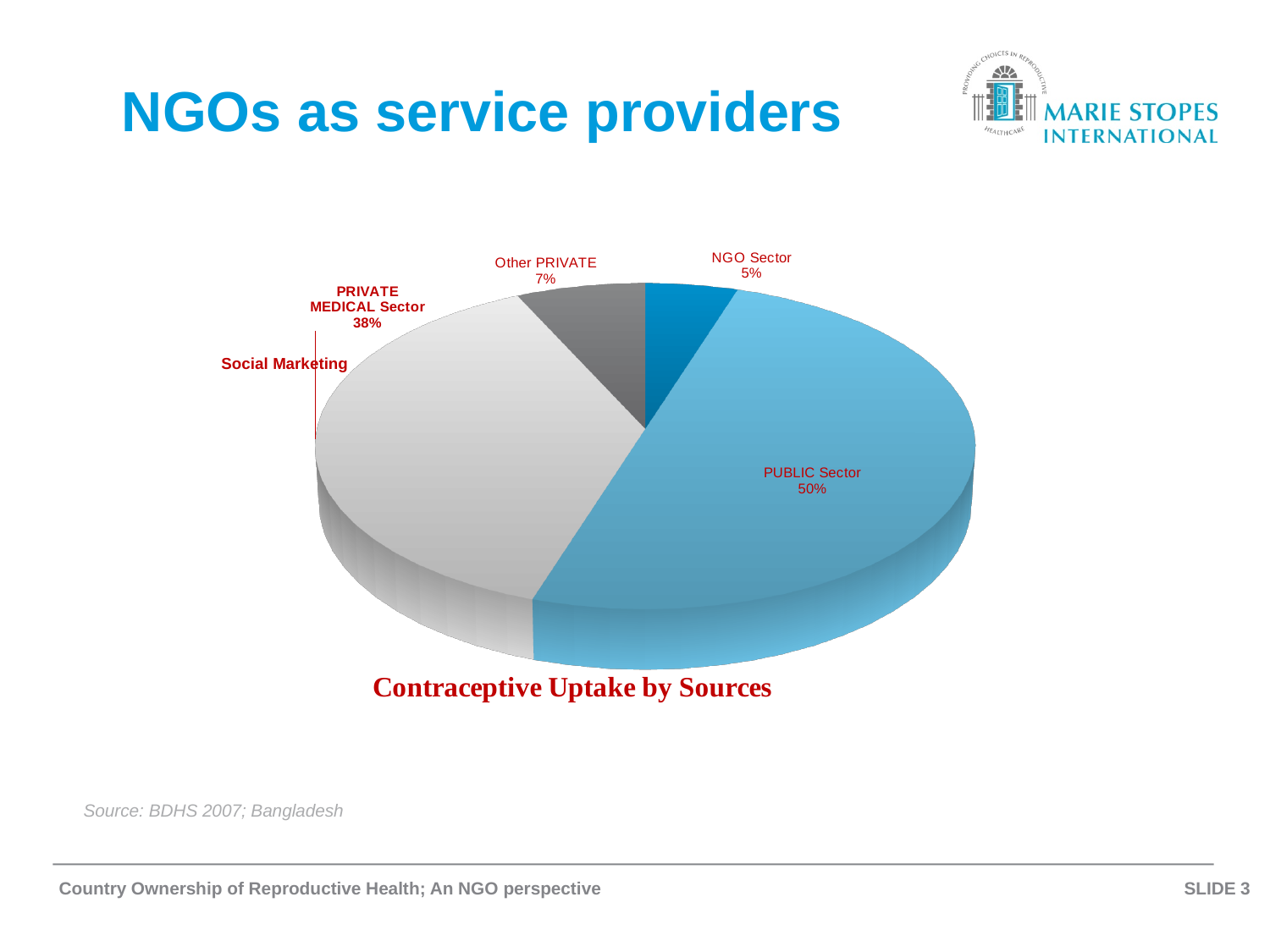
Which source has the smallest share of contraceptive uptake? NGO Sector What share of contraceptive uptake comes from the PRIVATE MEDICAL Sector? 38% What is the difference in percentage points between the PUBLIC Sector and the PRIVATE MEDICAL Sector shares? 12 What share of contraceptive uptake comes from Other PRIVATE sources? 7% How many slices does the pie chart have? 4 What is the title of the chart? Contraceptive Uptake by Sources What share of contraceptive uptake comes from the NGO Sector? 5% What kind of chart is shown on the slide? Pie chart What share of contraceptive uptake comes from the PUBLIC Sector? 50% What is the source cited for the chart data? BDHS 2007; Bangladesh Which is larger, the share for Other PRIVATE or the share for the NGO Sector? Other PRIVATE Which source has the largest share of contraceptive uptake? PUBLIC Sector